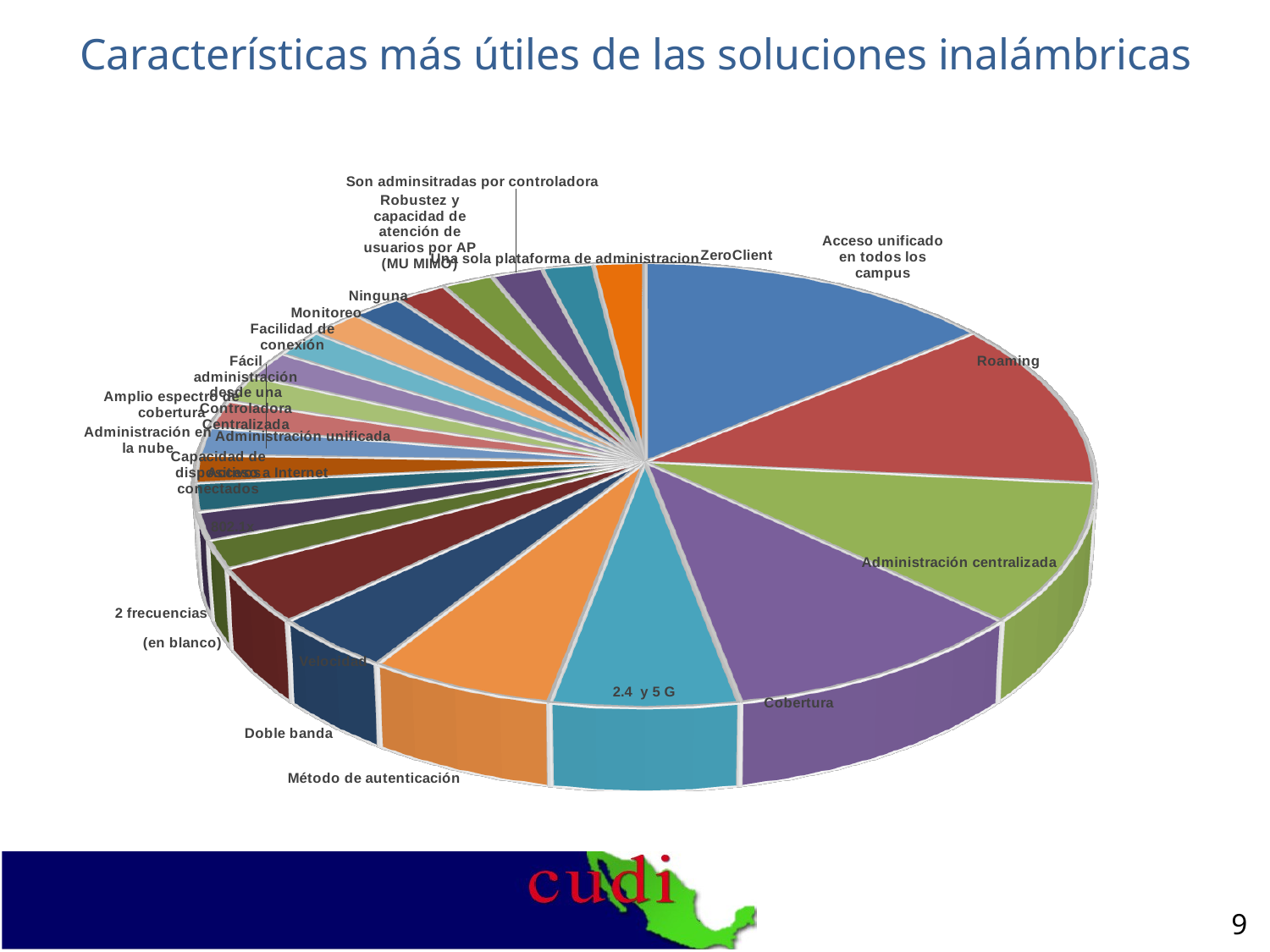
Which category has the largest slice in the pie chart? Acceso unificado en todos los campus Which slice is larger, Administración centralizada or Ninguna? Administración centralizada Which slice is larger, 2.4 y 5 G or Una sola plataforma de administracion? 2.4 y 5 G What is the title of the slide containing the pie chart? Características más útiles de las soluciones inalámbricas Which slice is larger, Método de autenticación or Facilidad de conexión? Método de autenticación What kind of chart is shown on the slide? pie chart